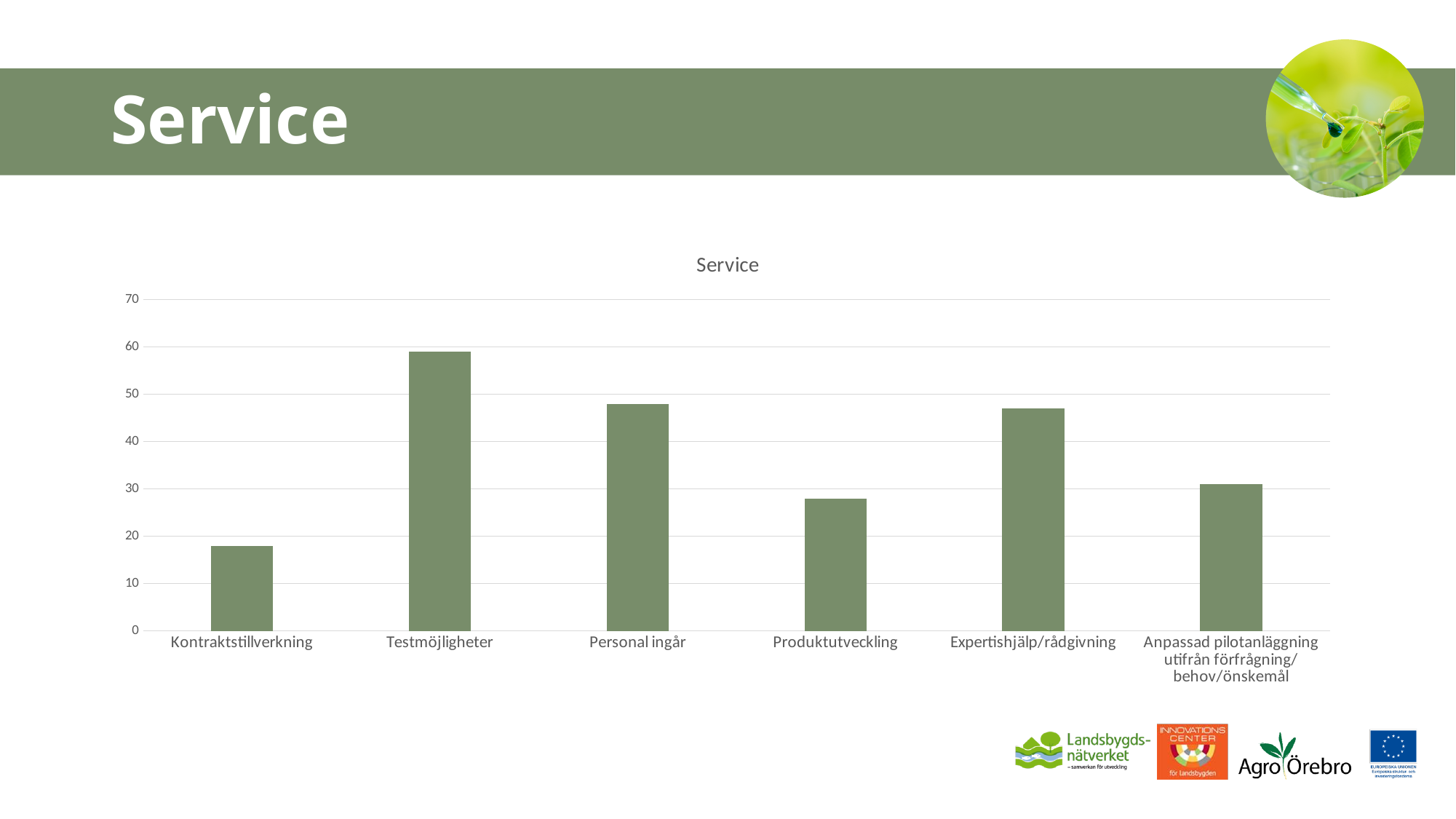
Which category has the highest bar? Testmöjligheter What kind of chart is shown on the slide? bar chart Is the value for Testmöjligheter greater or less than 50? greater How many categories are shown on the x axis of the chart? 6 Which is larger, the value for Kontraktstillverkning or the value for Expertishjälp/rådgivning? Expertishjälp/rådgivning Is the value for Kontraktstillverkning greater or less than 20? less Is the value for Personal ingår greater or less than 40? greater Which is larger, the value for Testmöjligheter or the value for Produktutveckling? Testmöjligheter What is the title of the chart? Service Which category has the lowest bar? Kontraktstillverkning